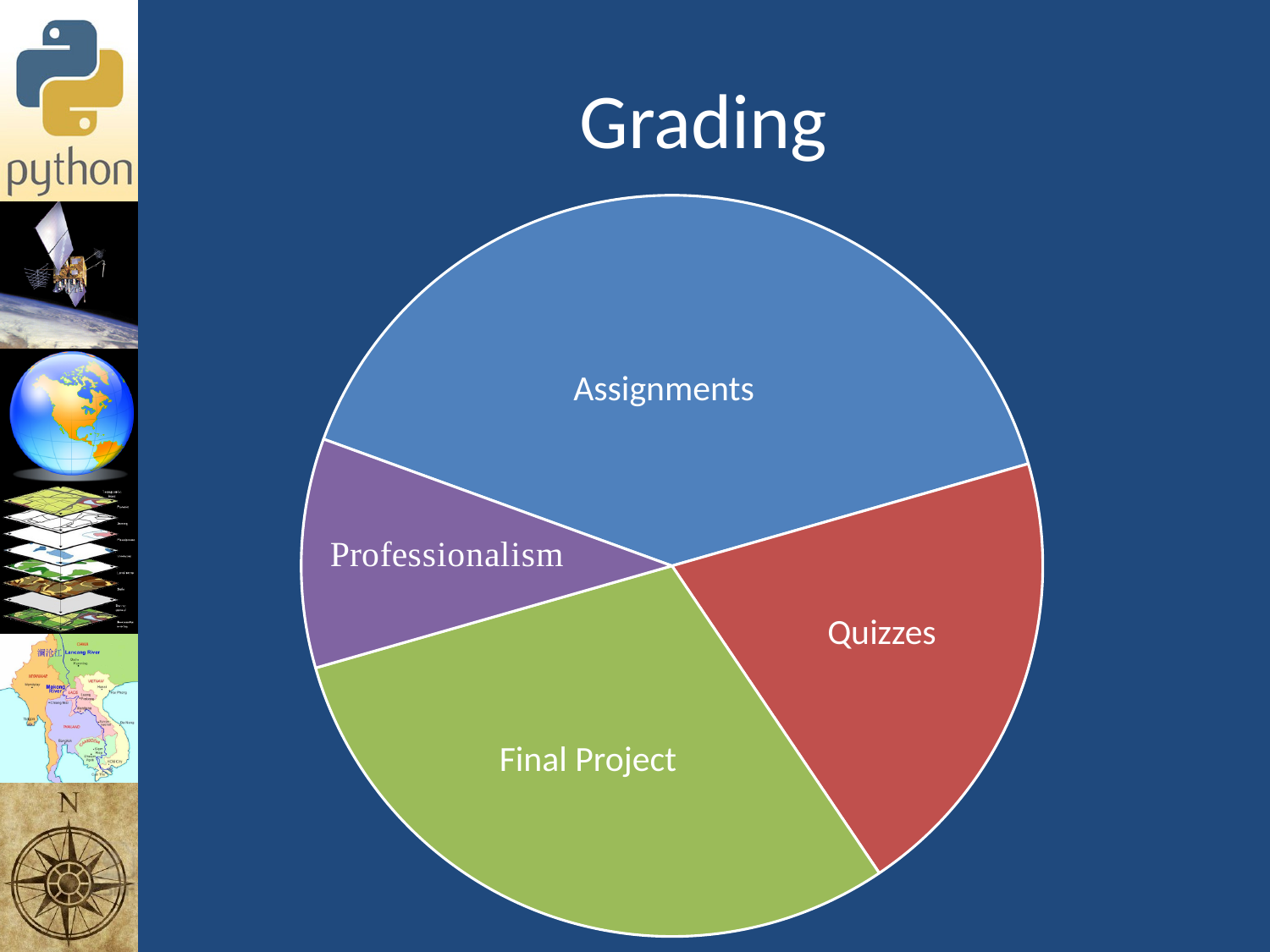
Which category has the largest slice of the pie chart? Assignments Which slice is larger, Assignments or Quizzes? Assignments Which category has the second-largest slice of the pie chart? Final Project What kind of chart is shown on the slide? pie chart How many slices does the pie chart have? 4 Which slice is larger, Quizzes or Professionalism? Quizzes What is the title of the slide containing the pie chart? Grading What colour is the Final Project slice of the pie chart? green Which slice is larger, Final Project or Quizzes? Final Project Which category has the smallest slice of the pie chart? Professionalism